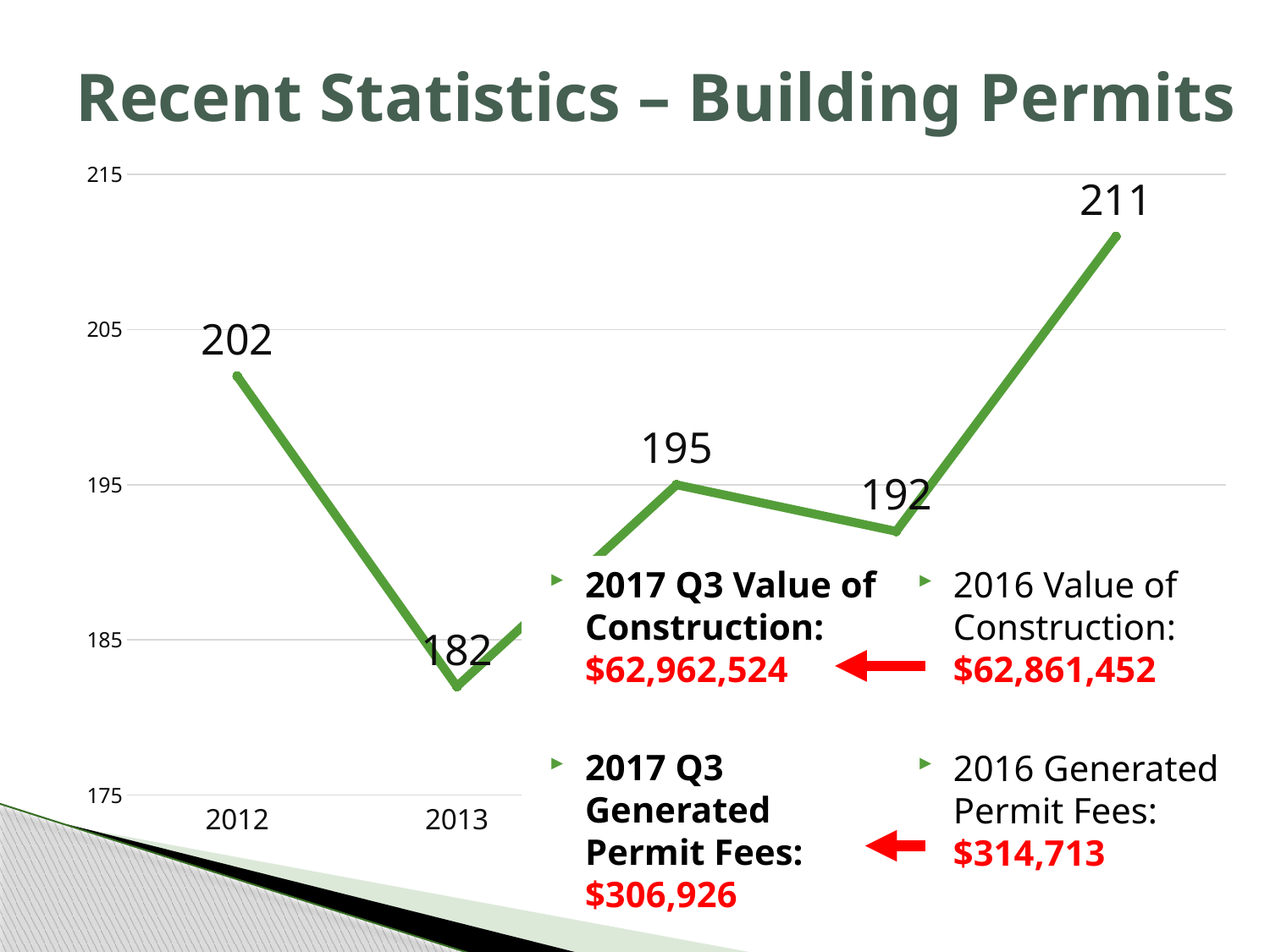
What is the lowest value labelled on the line? 182 What is the highest value labelled on the line? 211 What is the difference between the values for 2012 and 2013? 20 Is the value for 2012 greater or less than 195? greater What type of chart is shown on the slide? line chart Does the line rise or fall from 2012 to 2013? fall What is the title of the slide containing the chart? Recent Statistics – Building Permits What is the value plotted for 2012? 202 Which year has the lowest value on the chart? 2013 How many data points are plotted on the line? 5 What is the value plotted for 2013? 182 Which is larger, the value for 2012 or the value for 2013? 2012